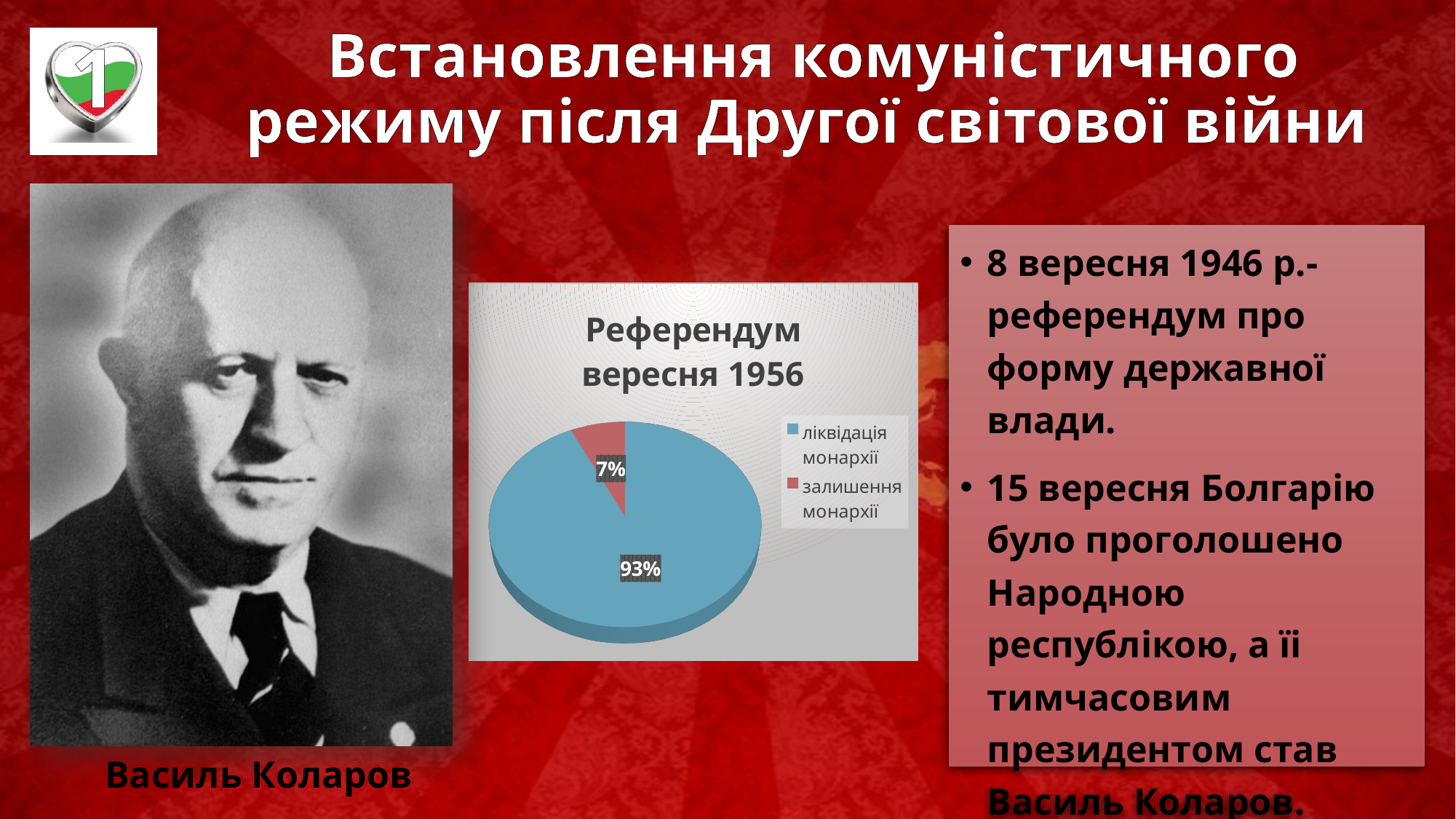
What colour is the slice for "залишення монархії"? red What is the difference in percentage points between "ліквідація монархії" and "залишення монархії"? 86 What share of the pie does "ліквідація монархії" take? 93% How many slices does the pie chart have? 2 Which slice of the pie is the smallest? залишення монархії What kind of chart is shown on the slide? pie chart How many entries does the legend list? 2 What is the title of the chart? Референдум вересня 1956 Which slice of the pie is the largest? ліквідація монархії What share of the pie does "залишення монархії" take? 7% Which is larger: the share for "ліквідація монархії" or for "залишення монархії"? ліквідація монархії